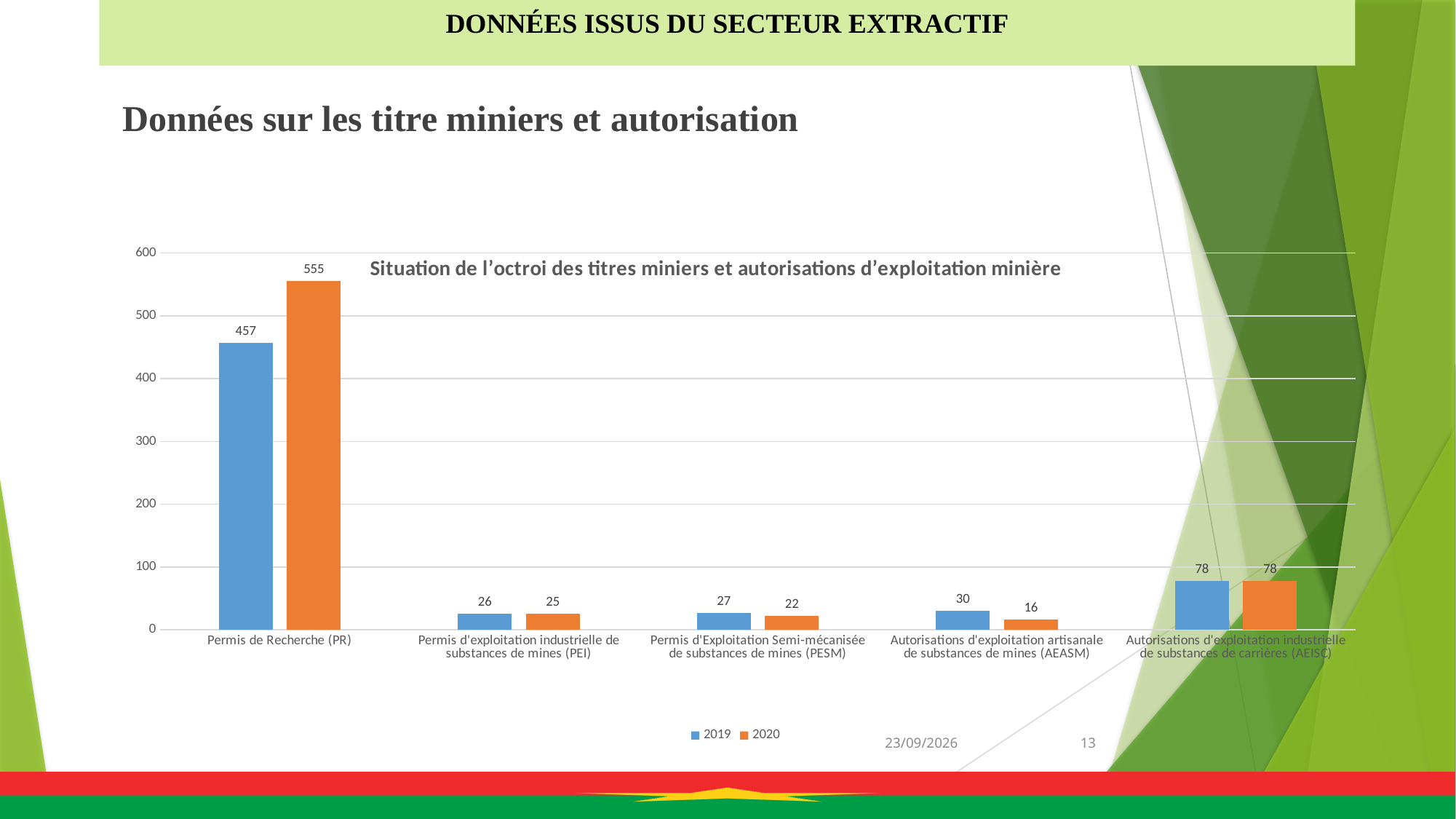
How many series does the legend list? 2 What is the difference between the 2020 and 2019 values for Permis de Recherche (PR)? 98 What is the 2019 value for Permis de Recherche (PR)? 457 What is the 2020 value for Autorisations d'exploitation artisanale de substances de mines (AEASM)? 16 What is the title of the chart? Situation de l'octroi des titres miniers et autorisations d'exploitation minière What is the 2020 value for Permis de Recherche (PR)? 555 What kind of chart is shown on the slide? Bar chart Which is larger for AEASM, the 2019 value or the 2020 value? 2019 How many categories are shown on the x axis? 5 What is the 2019 value for Permis d'Exploitation Semi-mécanisée de substances de mines (PESM)? 27 Which category has the highest 2020 value? Permis de Recherche (PR) Which category has the lowest 2020 value? Autorisations d'exploitation artisanale de substances de mines (AEASM)